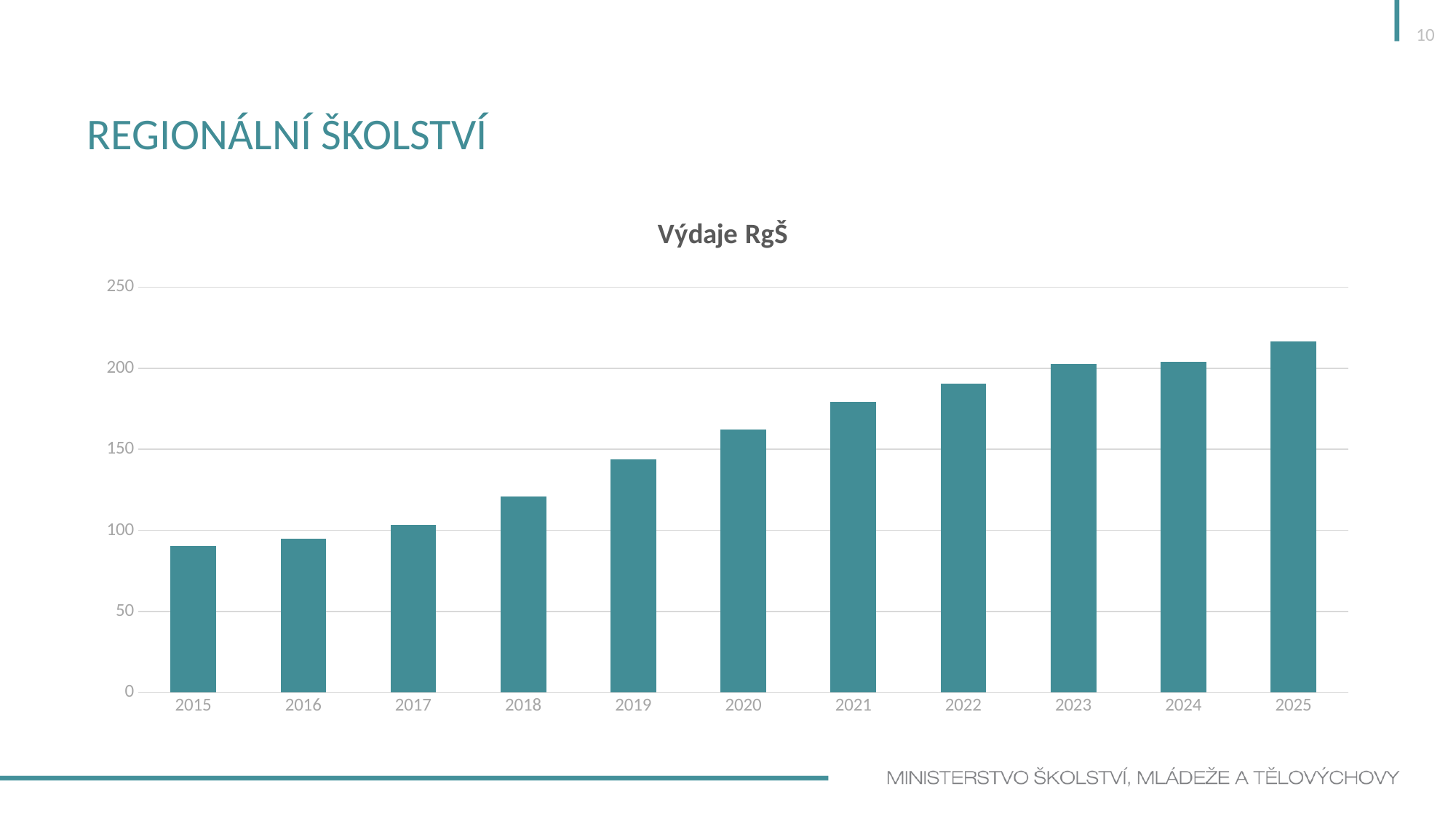
Do the values generally rise or fall from 2015 to 2025? rise Is the value for 2025 greater or less than 200? greater Which year has the lowest value in the chart? 2015 Is the value for 2015 greater or less than 100? less How many years are shown on the x axis of the chart? 11 Is the value for 2022 greater or less than 200? less Which year has the highest value in the chart? 2025 What is the title of the chart? Výdaje RgŠ Which year has the larger value, 2017 or 2020? 2020 What kind of chart is shown on the slide? bar chart